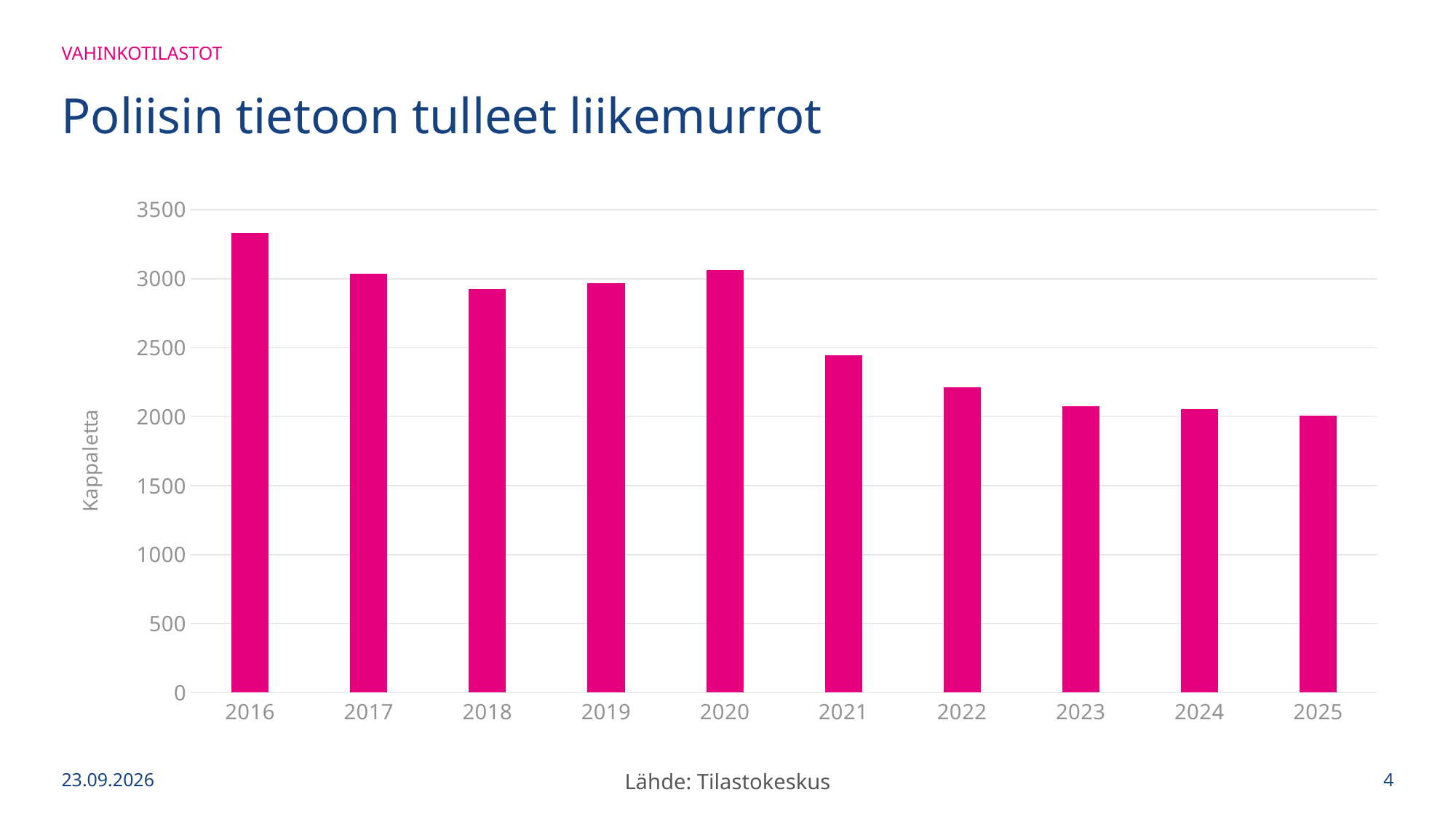
How many years are shown on the x axis of the chart? 10 Which is larger, the value for 2016 or the value for 2017? 2016 What is the label on the vertical axis of the chart? Kappaletta What is the title of the chart? Poliisin tietoon tulleet liikemurrot Which year has the highest number of reported business burglaries? 2016 Do the values generally rise or fall from 2016 to 2025? fall What kind of chart is shown on the slide? bar chart Is the value for 2016 greater or less than 3000? greater Is the value for 2021 greater or less than 2500? less Is the value for 2022 greater or less than 2000? greater Which is larger, the value for 2020 or the value for 2021? 2020